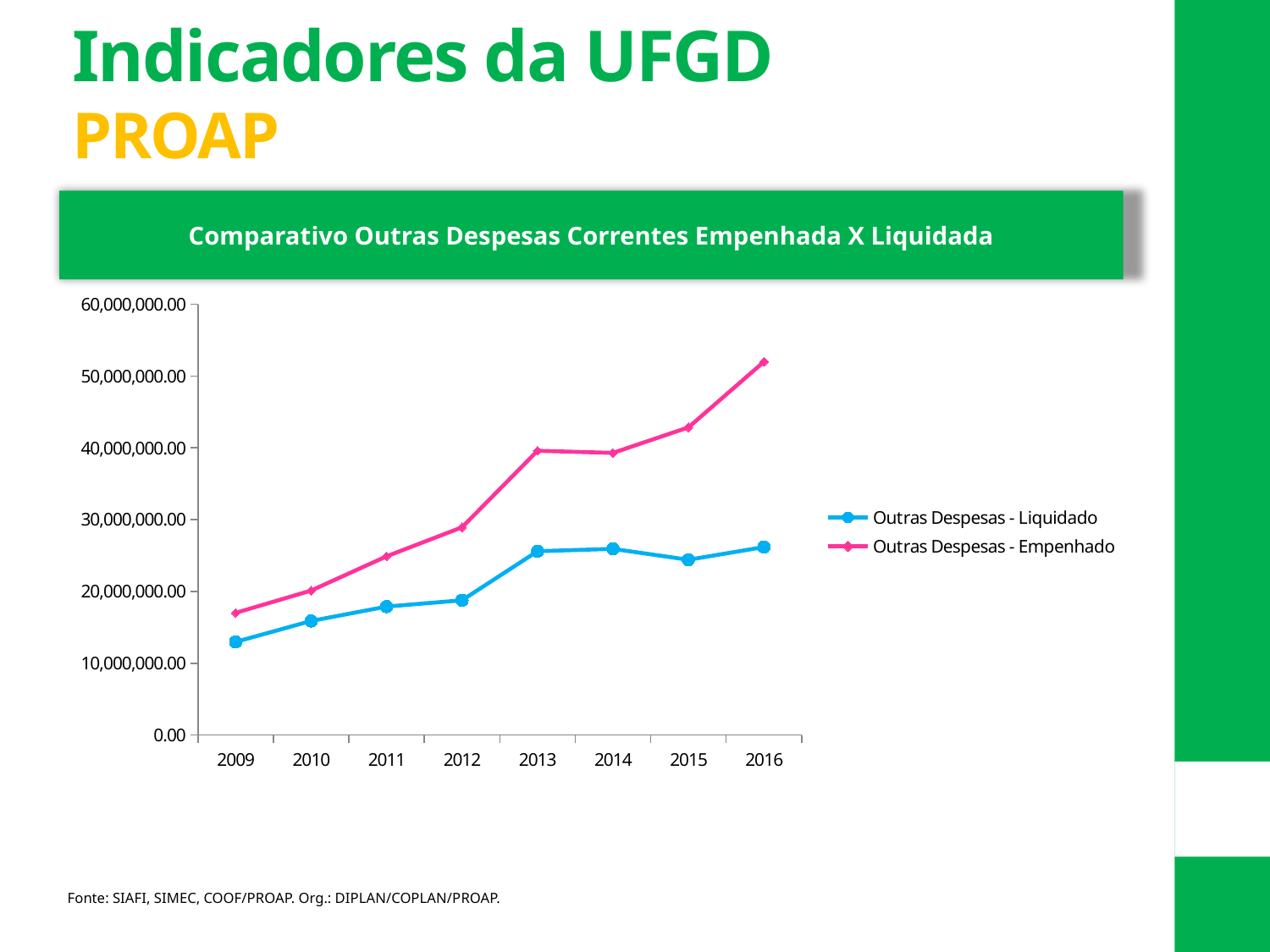
In which year is the value for Outras Despesas - Empenhado highest? 2016 In which year is the value for Outras Despesas - Liquidado lowest? 2009 Does the Outras Despesas - Empenhado series generally rise or fall from 2009 to 2016? rise Is the value for Outras Despesas - Liquidado in 2016 greater or less than 30,000,000.00? less What is the title of the chart? Comparativo Outras Despesas Correntes Empenhada X Liquidada Is the value for Outras Despesas - Liquidado in 2009 greater or less than 10,000,000.00? greater What kind of chart is shown on the slide? line chart How many series does the legend list? 2 In 2016, which series has the larger value: Outras Despesas - Liquidado or Outras Despesas - Empenhado? Outras Despesas - Empenhado Is the value for Outras Despesas - Empenhado in 2015 greater or less than 40,000,000.00? greater How many years are plotted along the x axis? 8